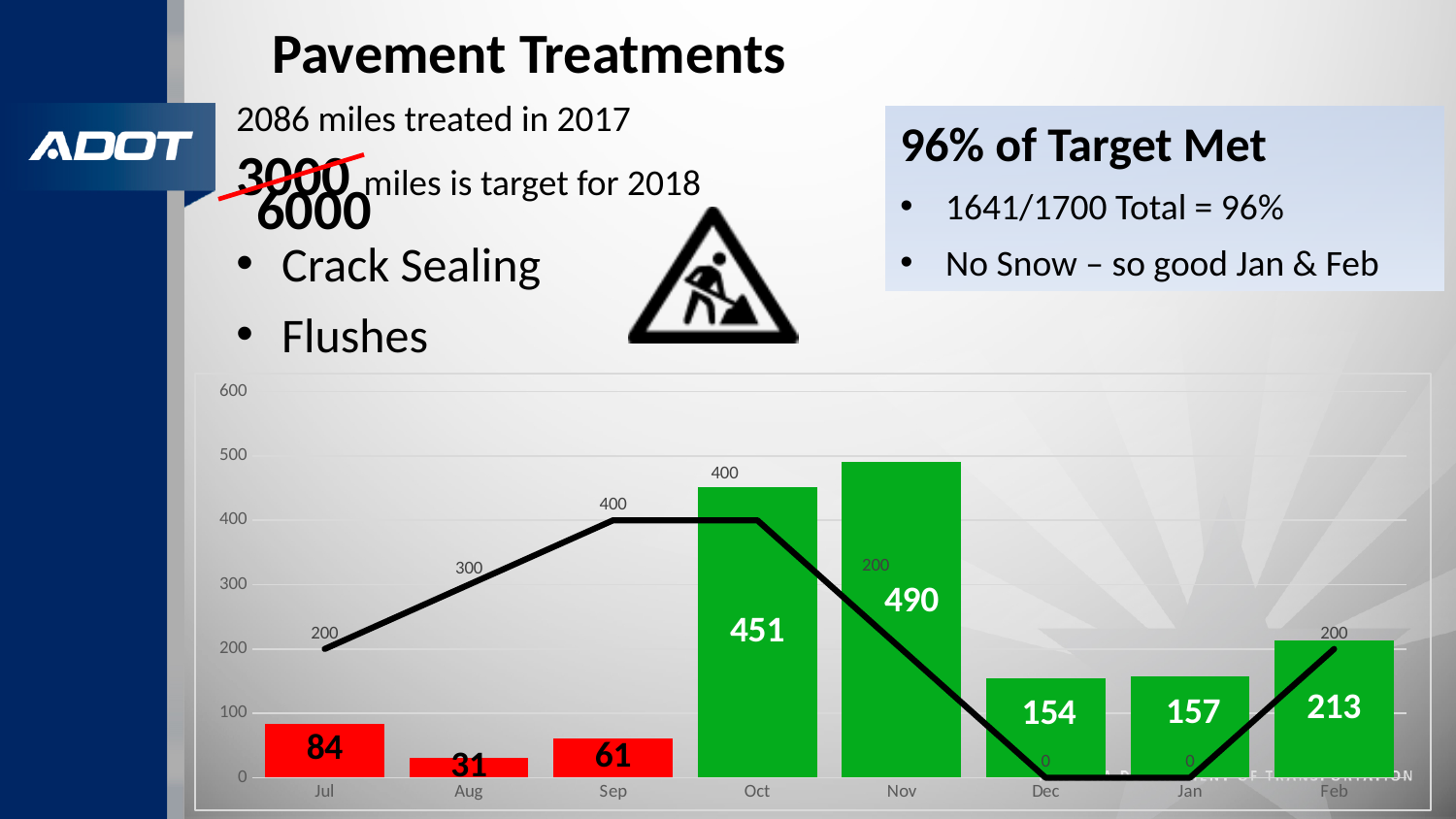
What kind of chart is this? Combined bar and line chart Do the bar values rise or fall from Jul to Aug? Fall What colour are the bars for Jul, Aug and Sep? Red What is the difference between the bar values for Nov and Oct? 39 Which month has the highest bar value? Nov What is the line value for Sep? 400 What is the bar value for Aug? 31 Which month has the lowest bar value? Aug What is the bar value for Feb? 213 Which is larger, the bar value for Dec or the bar value for Jan? Jan What is the bar value for Oct? 451 How many months are shown on the x axis? 8